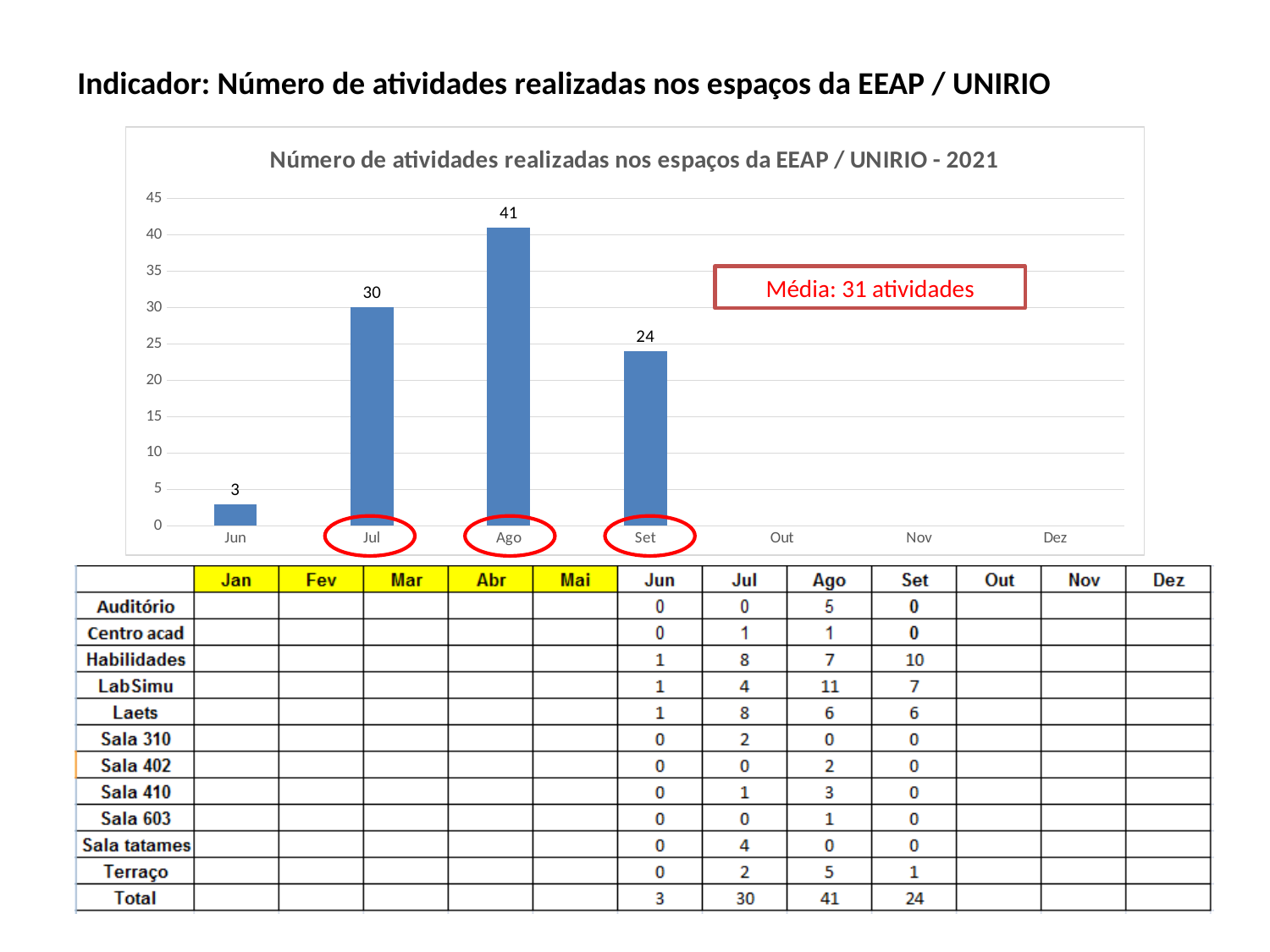
Which is larger, the value for Jul or the value for Set? Jul How many months on the x axis have a plotted bar? 4 What average value is stated in the red box on the chart? Média: 31 atividades What is the difference between the values for Jul and Set? 6 Which month has the highest value in the chart? Ago What is the value for Ago in the chart? 41 What is the value for Jun in the chart? 3 What is the difference between the values for Ago and Jul? 11 What is the title of the chart? Número de atividades realizadas nos espaços da EEAP / UNIRIO - 2021 What kind of chart is shown on the slide? Bar chart Which month with a plotted bar has the lowest value in the chart? Jun What is the value for Set in the chart? 24